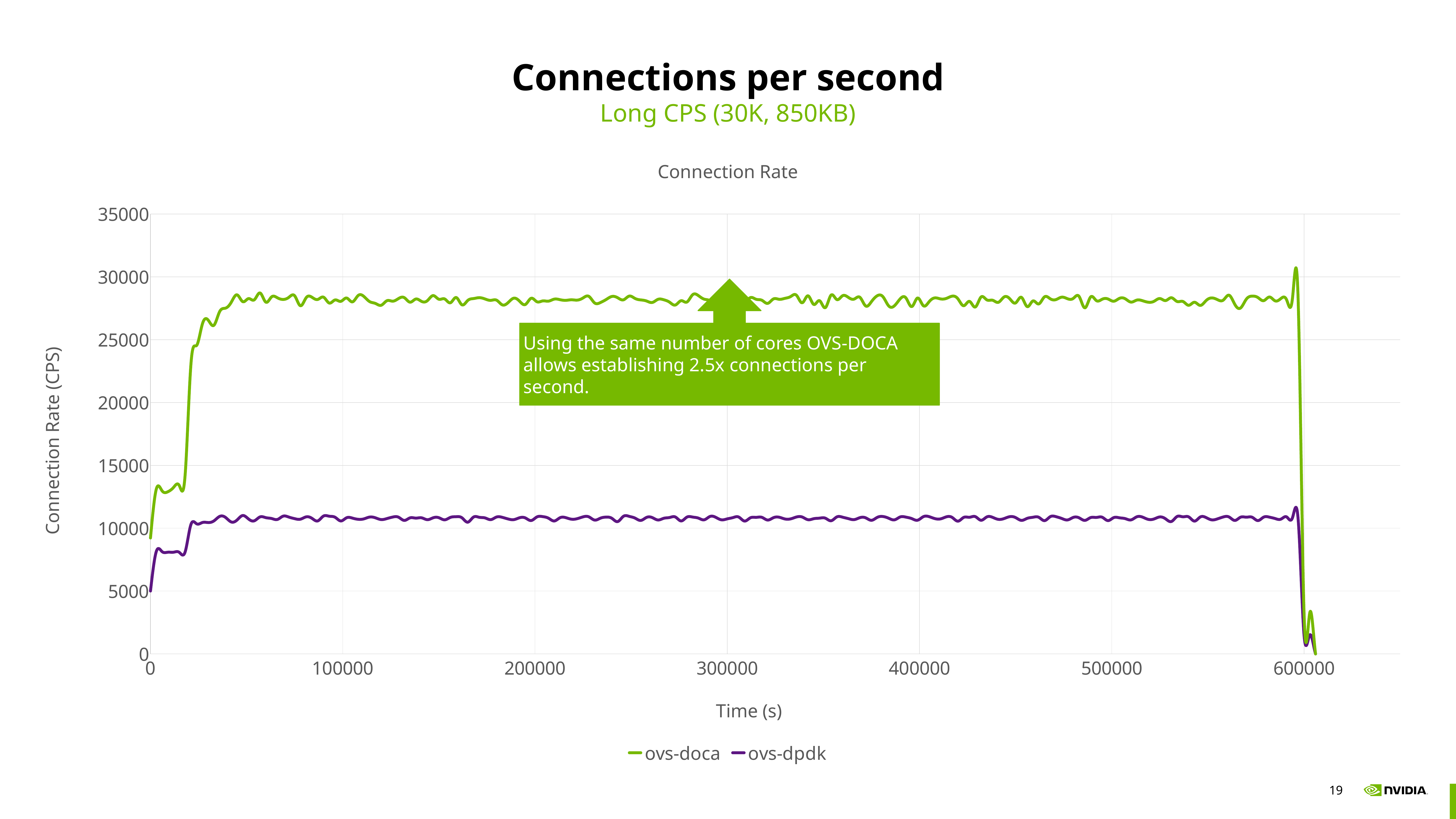
How many series does the legend list? 2 Which series has the higher connection rate for most of the run, ovs-doca or ovs-dpdk? ovs-doca What is the label of the y axis? Connection Rate (CPS) Is the ovs-dpdk connection rate at time 300000 s greater or less than 15000? less Does the ovs-doca connection rate rise or fall between time 0 and time 50000 s? rise Which series is drawn in purple? ovs-dpdk Which two series are listed in the legend? ovs-doca and ovs-dpdk What kind of chart is shown on the slide? line chart Is the ovs-dpdk connection rate at time 300000 s greater or less than 10000? greater Is the ovs-doca connection rate at time 300000 s greater or less than 25000? greater What is the highest tick value shown on the y axis? 35000